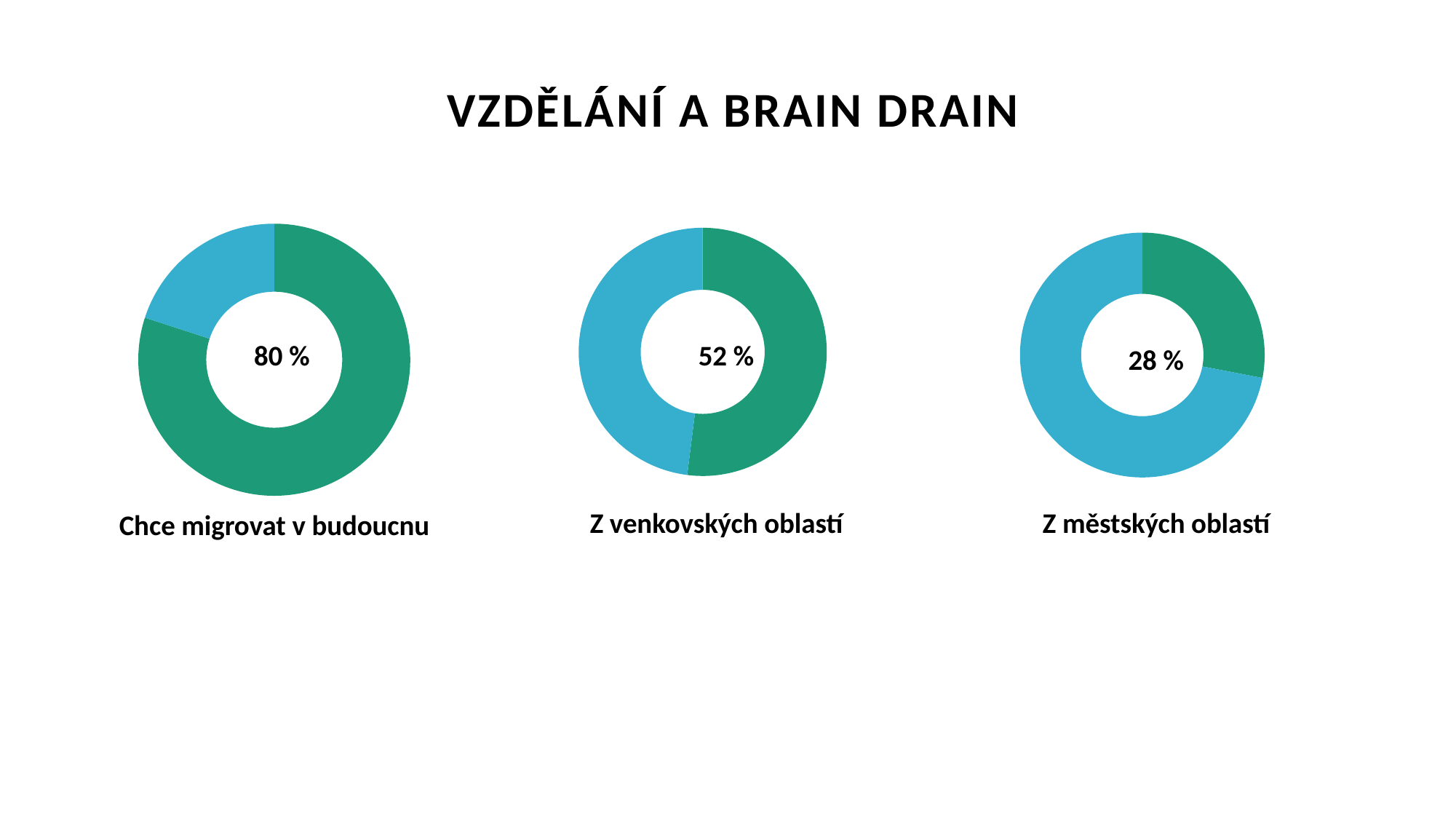
What value is shown in the centre of the 'Chce migrovat v budoucnu' donut chart? 80 % What value is shown in the centre of the 'Z venkovských oblastí' donut chart? 52 % Which of the three donut charts shows the lowest percentage? Z městských oblastí What is the difference between the percentage in the 'Z venkovských oblastí' chart and the 'Z městských oblastí' chart? 24 % Which is larger: the percentage in the 'Z venkovských oblastí' chart or the 'Z městských oblastí' chart? Z venkovských oblastí In the 'Z městských oblastí' chart, what colour is the larger segment? Light blue How many donut charts are shown on the slide? 3 What kind of chart is used for 'Chce migrovat v budoucnu'? Donut (pie) chart What is the difference between the percentage in the 'Chce migrovat v budoucnu' chart and the 'Z venkovských oblastí' chart? 28 % Which of the three donut charts shows the highest percentage? Chce migrovat v budoucnu What is the title of the slide? VZDĚLÁNÍ A BRAIN DRAIN What value is shown in the centre of the 'Z městských oblastí' donut chart? 28 %